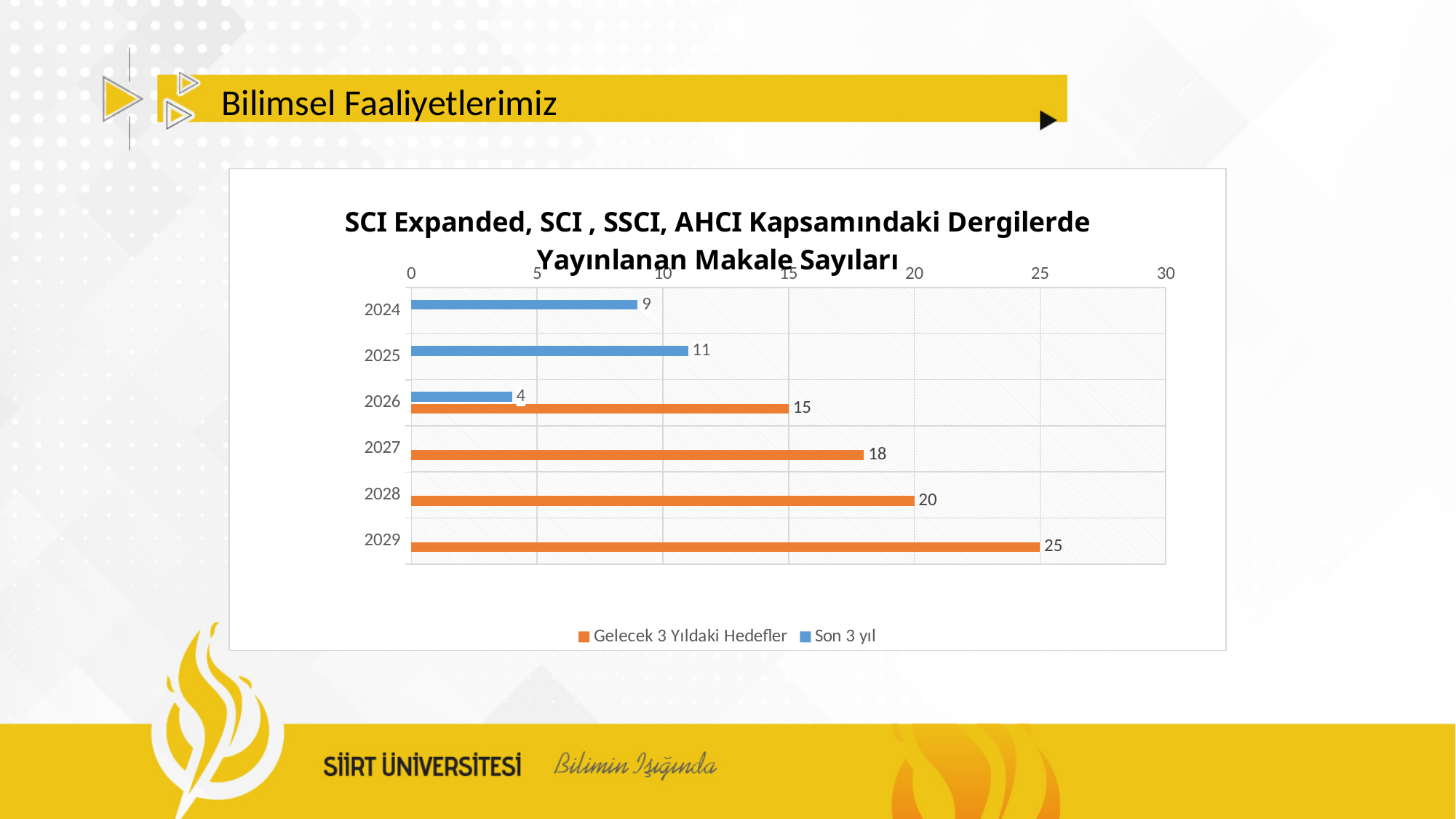
What is the value for 2025 in the "Son 3 yıl" series? 11 How many years are shown on the vertical axis of the chart? 6 Which year has the highest value in the "Gelecek 3 Yıldaki Hedefler" series? 2029 What is the value for 2029 in the "Gelecek 3 Yıldaki Hedefler" series? 25 What kind of chart is shown on the slide? Bar chart What is the difference between the "Gelecek 3 Yıldaki Hedefler" value for 2028 and the value for 2026? 5 What is the value for 2024 in the "Son 3 yıl" series? 9 For 2026, which series has the larger value: "Son 3 yıl" or "Gelecek 3 Yıldaki Hedefler"? Gelecek 3 Yıldaki Hedefler How many series does the legend list? 2 Do the "Gelecek 3 Yıldaki Hedefler" values rise or fall from 2026 to 2029? Rise What is the value for 2027 in the "Gelecek 3 Yıldaki Hedefler" series? 18 Which year has the lowest value in the "Son 3 yıl" series? 2026